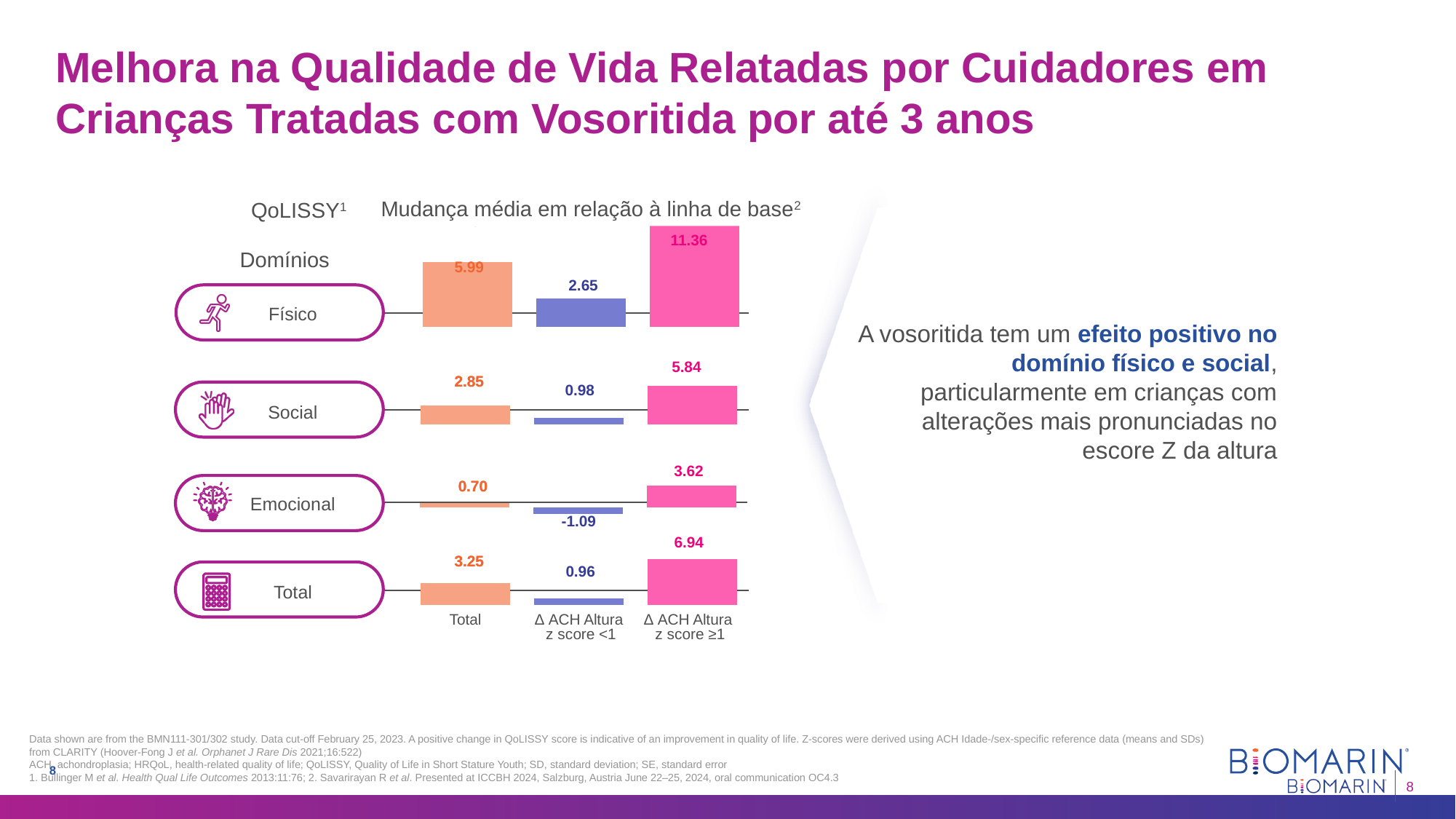
What type of chart is used to show the mean change from baseline for each domain? Bar chart In the Físico domain chart, what is the value for the Δ ACH Altura z score ≥1 group? 11.36 How many groups (bars) are shown in each domain chart? 3 In the Emocional domain chart, what is the value for the Δ ACH Altura z score <1 group? -1.09 In the Físico domain chart, what is the difference between the Δ ACH Altura z score ≥1 value and the Total value? 5.37 Which domain has the highest value for the Δ ACH Altura z score ≥1 group? Físico In the Social domain chart, which is larger: the Total value or the Δ ACH Altura z score ≥1 value? Δ ACH Altura z score ≥1 In the Social domain chart, what is the value for the Δ ACH Altura z score <1 group? 0.98 In the Total domain chart, which group has the highest mean change from baseline? Δ ACH Altura z score ≥1 In the Físico domain chart, what is the mean change from baseline for the Total group? 5.99 In the Emocional domain chart, which group has the lowest value? Δ ACH Altura z score <1 In the Total domain chart, what is the difference between the Total value and the Δ ACH Altura z score <1 value? 2.29